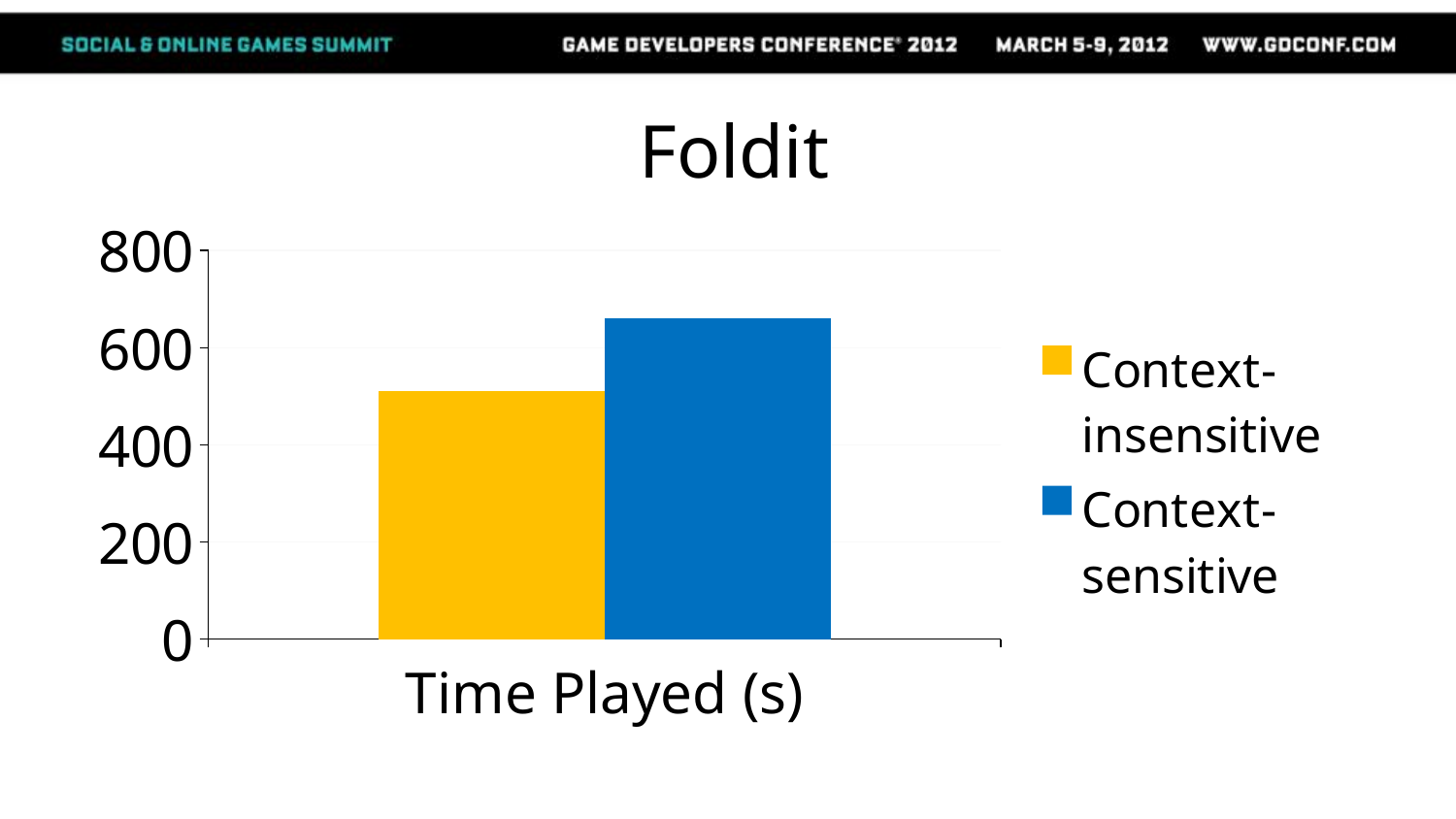
Is the value for Context-sensitive greater or less than 800? less What is the label on the x axis of the chart? Time Played (s) Is the value for Context-insensitive greater or less than 400? greater Which series has the highest Time Played (s)? Context-sensitive How many series does the legend list? 2 What is the title of the chart? Foldit Which series has the lowest Time Played (s)? Context-insensitive What type of chart is shown on the slide? bar chart Is the value for Context-sensitive greater or less than 600? greater How many categories are shown on the x axis? 1 Which series has the higher Time Played (s), Context-insensitive or Context-sensitive? Context-sensitive